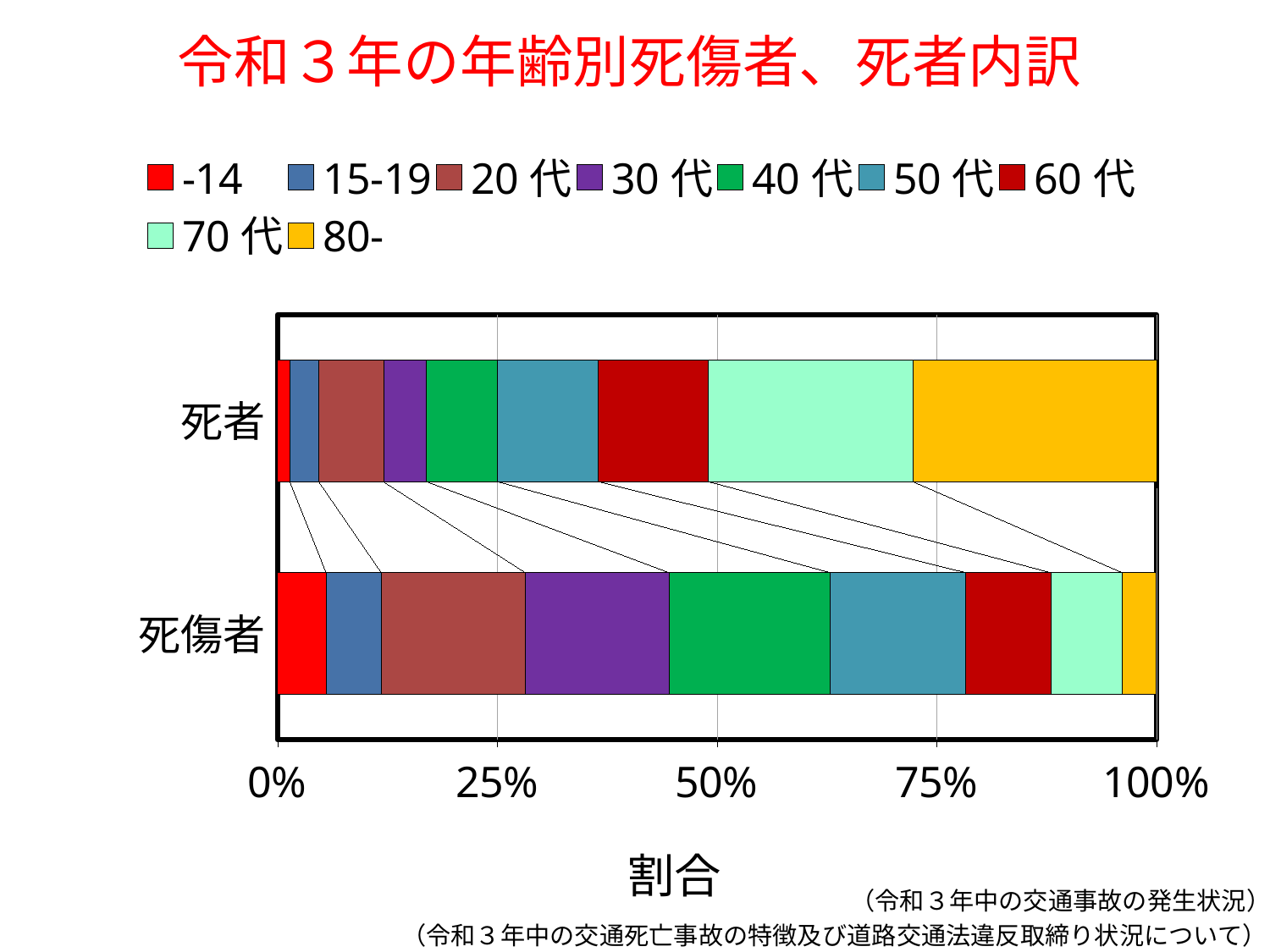
Which bar has the larger share for 80-, 死者 or 死傷者? 死者 Is the share of 80- in the 死者 bar greater or less than 25%? greater What kind of chart is shown on the slide? Stacked bar chart Which bar has the larger share for 30 代, 死者 or 死傷者? 死傷者 What value does each stacked bar total on the horizontal axis? 100% How many series does the legend list? 9 Is the share of 20 代 in the 死傷者 bar greater or less than 25%? less Which age group has the smallest share in the 死者 bar? -14 Which age group has the largest share in the 死者 bar? 80- What is the title of the chart? 令和３年の年齢別死傷者、死者内訳 What is the label of the horizontal axis? 割合 How many bars (categories) does the chart show? 2